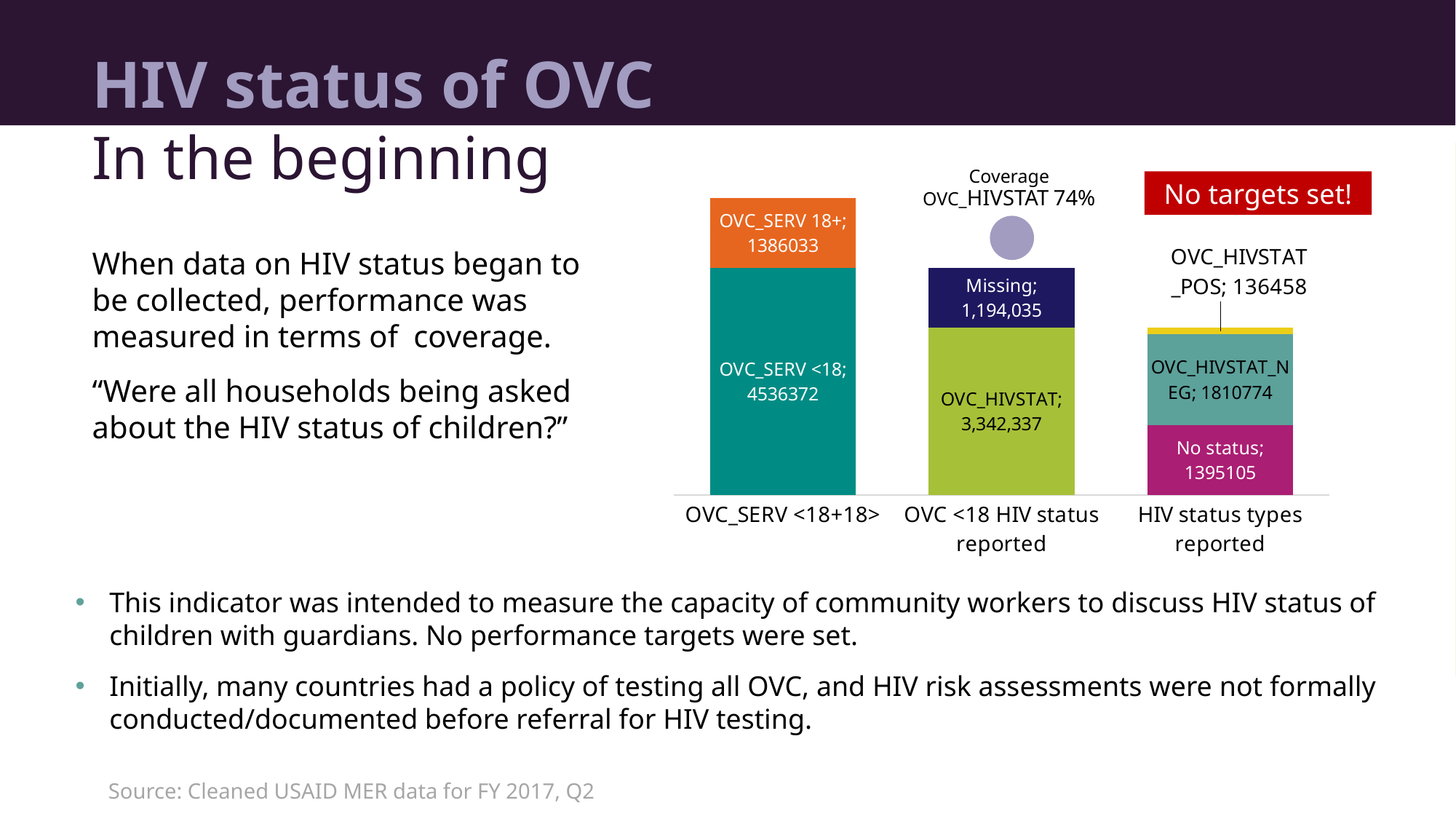
What is the value of the OVC_SERV 18+ segment? 1386033 What is the value of OVC_HIVSTAT_POS in the HIV status types reported bar? 136458 How many bars (categories) are plotted along the x axis? 3 What is the value of the Missing segment in the OVC <18 HIV status reported bar? 1,194,035 Which is larger, the OVC_HIVSTAT_NEG segment or the No status segment? OVC_HIVSTAT_NEG Which segment in the HIV status types reported bar is the smallest? OVC_HIVSTAT_POS What is the value of the OVC_HIVSTAT segment? 3,342,337 What is the difference between the OVC_HIVSTAT segment and the Missing segment? 2,148,302 What kind of chart is shown on the slide? Stacked bar chart What is the value of the No status segment? 1395105 What coverage percentage for OVC_HIVSTAT is shown above the middle bar? 74% What is the value of the OVC_SERV <18 segment in the OVC_SERV <18+18> bar? 4536372